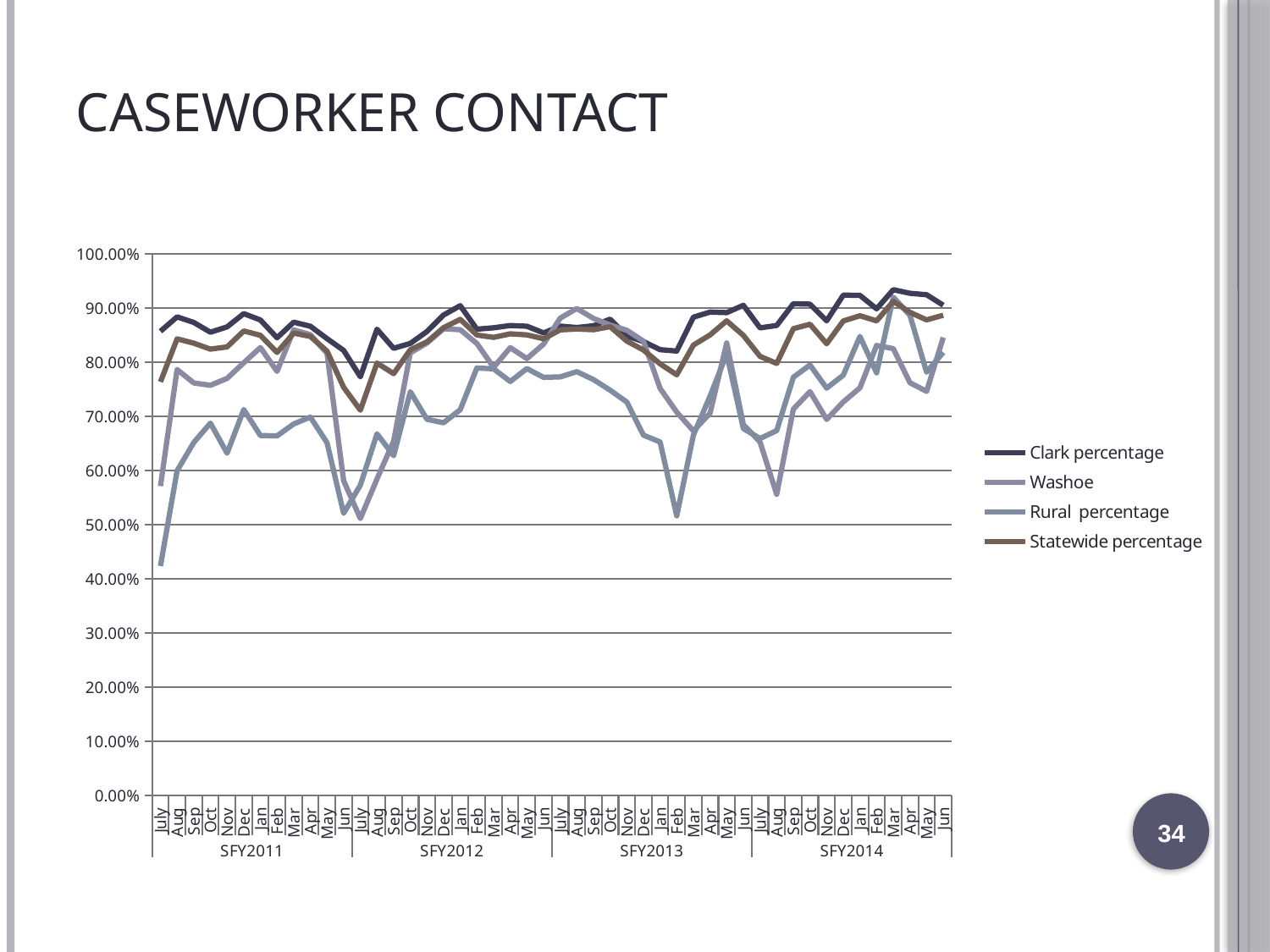
Is the Clark percentage for July SFY2011 greater or less than 80.00%? greater Is the Rural percentage for July SFY2011 greater or less than 50.00%? less How many series does the legend list? 4 Is the Statewide percentage for Jun SFY2011 greater or less than 80.00%? less Which series has the highest value in Jun SFY2014? Clark percentage What type of chart is shown on the slide? line chart Which is larger in July SFY2011, the Clark percentage or the Rural percentage? Clark percentage What is the title of the slide containing the chart? CASEWORKER CONTACT Which series has the lowest value in July SFY2011? Rural percentage Which series is listed last in the legend? Statewide percentage How many state fiscal years are shown along the x axis? 4